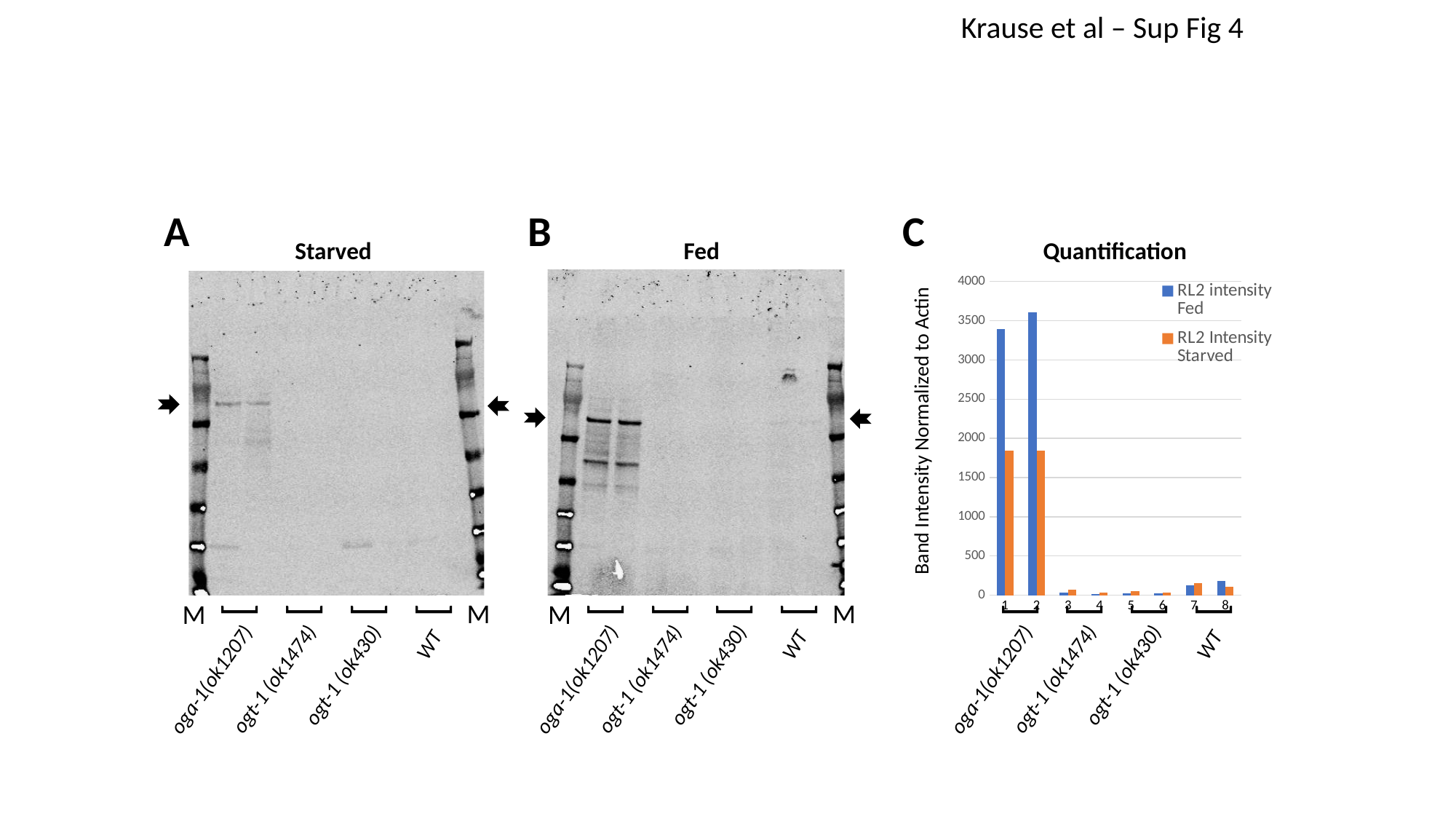
What is the y-axis label of the Quantification chart? Band Intensity Normalized to Actin In the Quantification chart, is the RL2 Intensity Starved value for category 2 greater or less than 1500? greater In the Quantification chart, which numbered category has the highest RL2 intensity Fed bar? 2 In the Quantification chart, which colour represents RL2 Intensity Starved? orange How many numbered categories are plotted along the x axis of the Quantification chart? 8 In the Quantification chart, is the RL2 intensity Fed value for category 1 greater or less than 3000? greater How many series does the legend of the Quantification chart list? 2 What kind of chart is the Quantification chart? bar chart In the Quantification chart, is the RL2 intensity Fed value for category 2 greater or less than 3500? greater In the Quantification chart, for category 1, which is larger: RL2 intensity Fed or RL2 Intensity Starved? RL2 intensity Fed